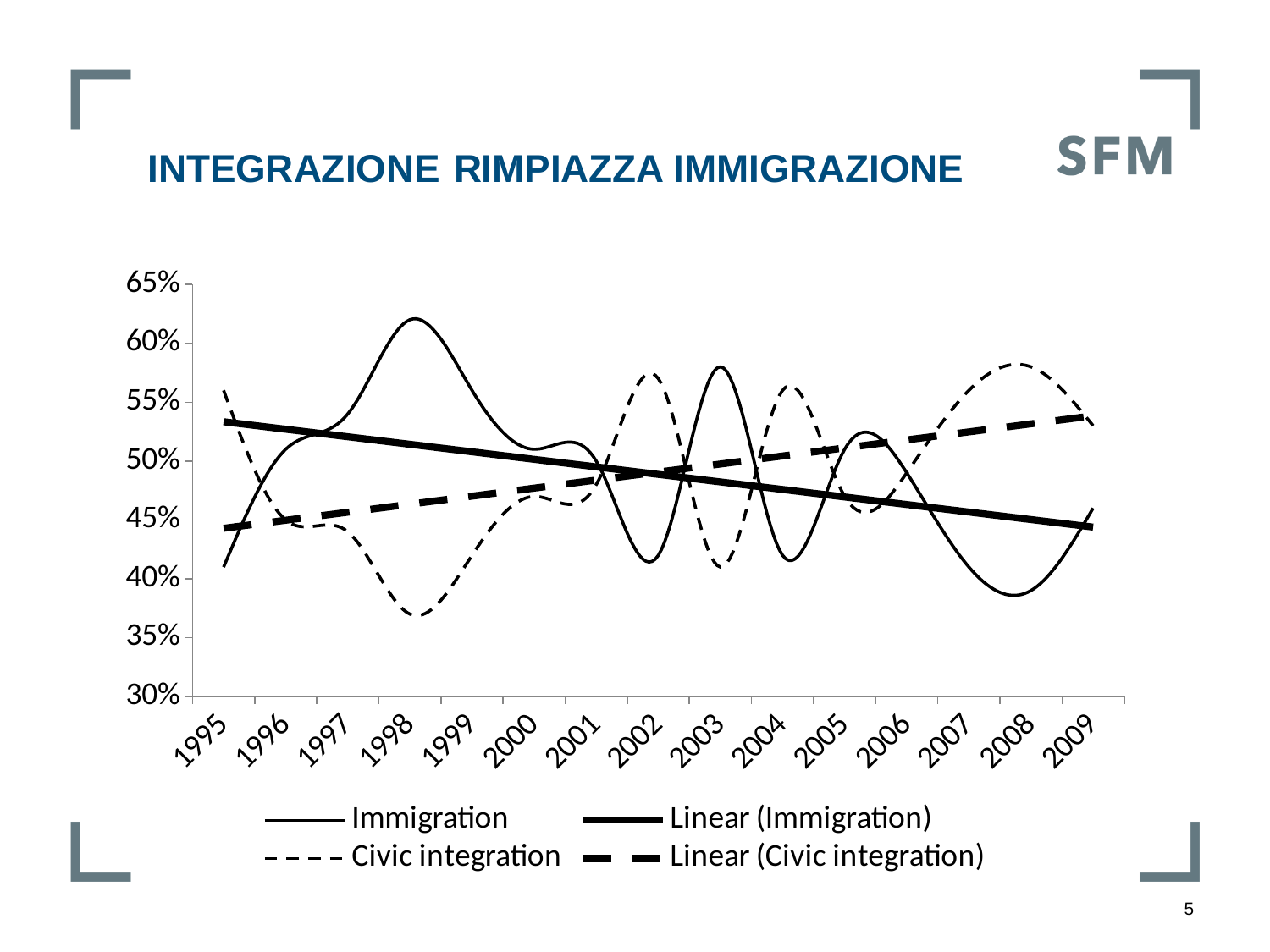
In which year does the Civic integration series reach its lowest value? 1998 In 2002, which series has the higher value, Immigration or Civic integration? Civic integration In 1998, which series has the higher value, Immigration or Civic integration? Immigration Is the Civic integration value for 2008 greater or less than 55%? greater Does the Linear (Immigration) trend line rise or fall from 1995 to 2009? fall How many series does the legend list? 4 Is the Immigration value for 1995 greater or less than 45%? less Does the Linear (Civic integration) trend line rise or fall from 1995 to 2009? rise What kind of chart is shown on the slide? line chart How many years are shown on the x axis? 15 Is the Immigration value for 1998 greater or less than 55%? greater